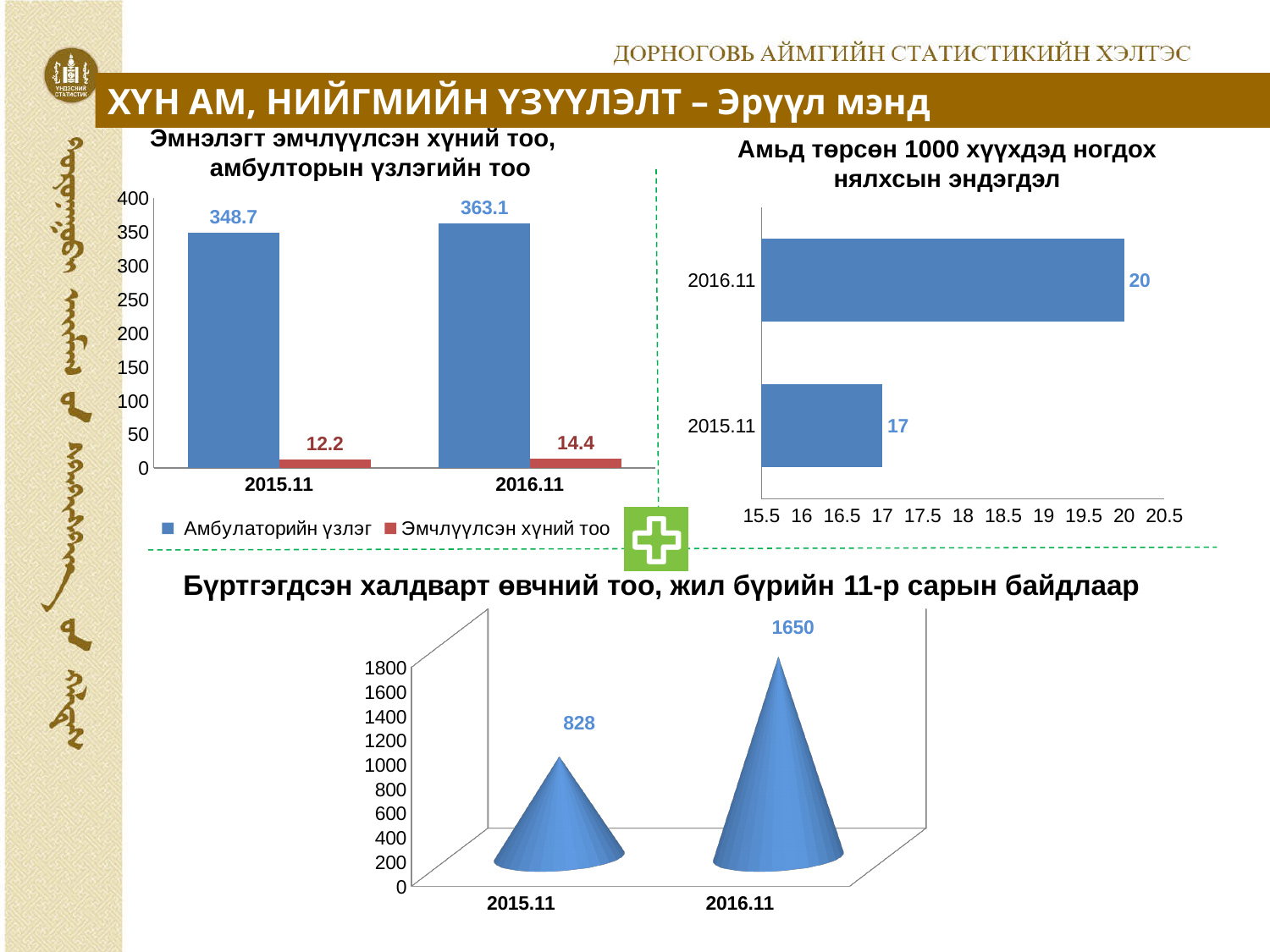
In the top-right chart 'Амьд төрсөн 1000 хүүхдэд ногдох нялхсын эндэгдэл', what is the difference between 2016.11 and 2015.11? 3 In the top-left chart 'Эмнэлэгт эмчлүүлсэн хүний тоо, амбулторын үзлэгийн тоо', what is the value of Эмчлүүлсэн хүний тоо for 2015.11? 12.2 In the top-right chart 'Амьд төрсөн 1000 хүүхдэд ногдох нялхсын эндэгдэл', what is the value for 2015.11? 17 In the top-left chart 'Эмнэлэгт эмчлүүлсэн хүний тоо, амбулторын үзлэгийн тоо', by how much did Амбулаторийн үзлэг increase from 2015.11 to 2016.11? 14.4 In the top-left chart 'Эмнэлэгт эмчлүүлсэн хүний тоо, амбулторын үзлэгийн тоо', how many series does the legend list? 2 What kind of chart is the top-right chart 'Амьд төрсөн 1000 хүүхдэд ногдох нялхсын эндэгдэл'? bar chart In the top-left chart 'Эмнэлэгт эмчлүүлсэн хүний тоо, амбулторын үзлэгийн тоо', does Эмчлүүлсэн хүний тоо rise or fall from 2015.11 to 2016.11? rise In the bottom chart 'Бүртгэгдсэн халдварт өвчний тоо, жил бүрийн 11-р сарын байдлаар', what is the value for 2016.11? 1650 In the top-right chart 'Амьд төрсөн 1000 хүүхдэд ногдох нялхсын эндэгдэл', which period has the higher value? 2016.11 In the top-left chart 'Эмнэлэгт эмчлүүлсэн хүний тоо, амбулторын үзлэгийн тоо', which series is shown in red? Эмчлүүлсэн хүний тоо In the top-left chart 'Эмнэлэгт эмчлүүлсэн хүний тоо, амбулторын үзлэгийн тоо', what is the value of Амбулаторийн үзлэг for 2016.11? 363.1 In the bottom chart 'Бүртгэгдсэн халдварт өвчний тоо, жил бүрийн 11-р сарын байдлаар', what is the difference between 2016.11 and 2015.11? 822